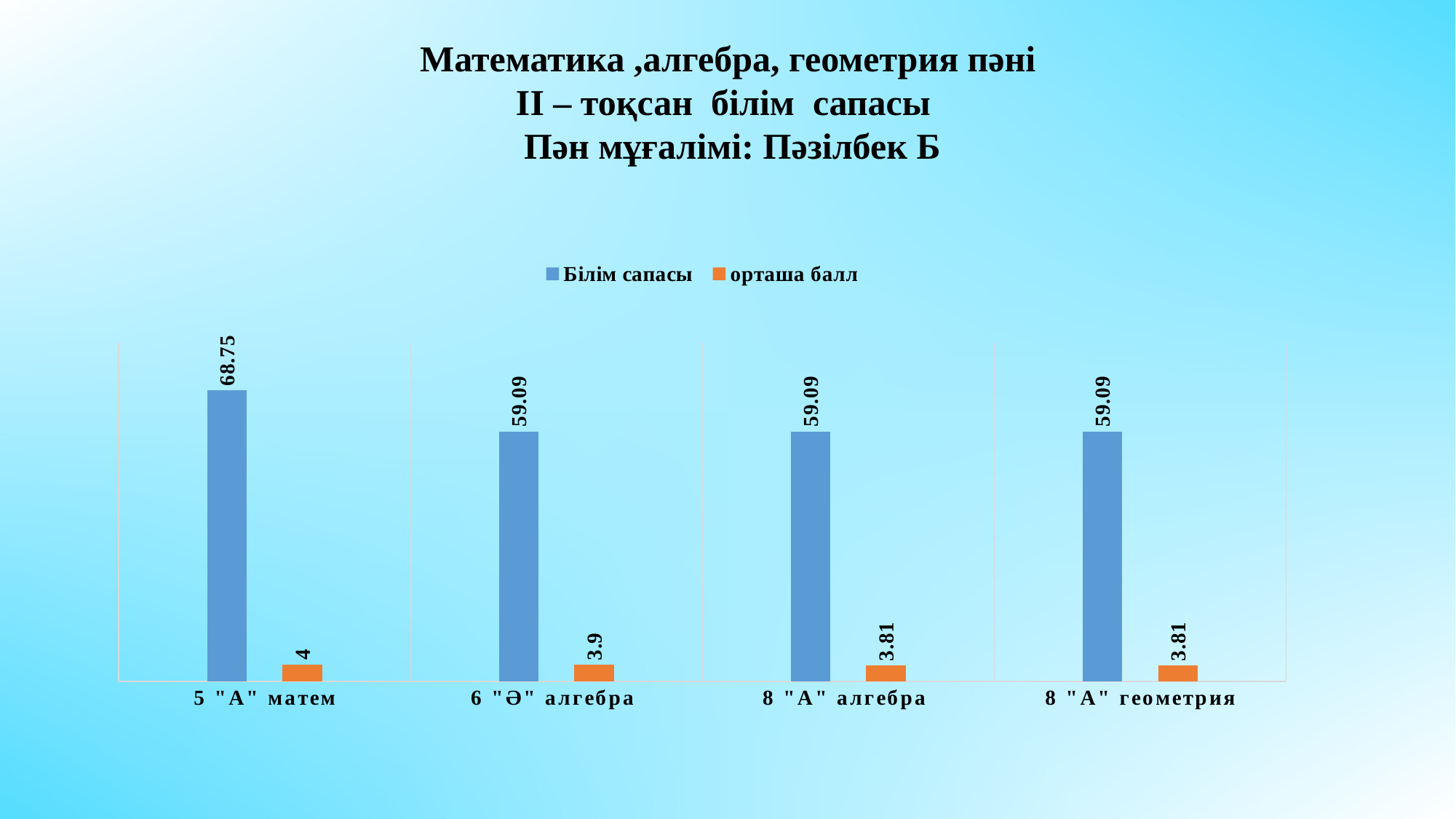
What is the Білім сапасы value for 8 "А" алгебра? 59.09 Which category has the highest Білім сапасы value? 5 "А" матем Which is larger, the орташа балл for 5 "А" матем or for 6 "Ә" алгебра? 5 "А" матем What is the орташа балл value for 8 "А" геометрия? 3.81 What is the Білім сапасы value for 5 "А" матем? 68.75 What is the difference between the орташа балл values for 5 "А" матем and 8 "А" алгебра? 0.19 How many series does the legend list? 2 What is the difference between the Білім сапасы values for 5 "А" матем and 6 "Ә" алгебра? 9.66 Which series is shown in orange in the legend? орташа балл What is the орташа балл value for 6 "Ә" алгебра? 3.9 How many categories are shown on the x axis? 4 What kind of chart is shown on the slide? Bar chart